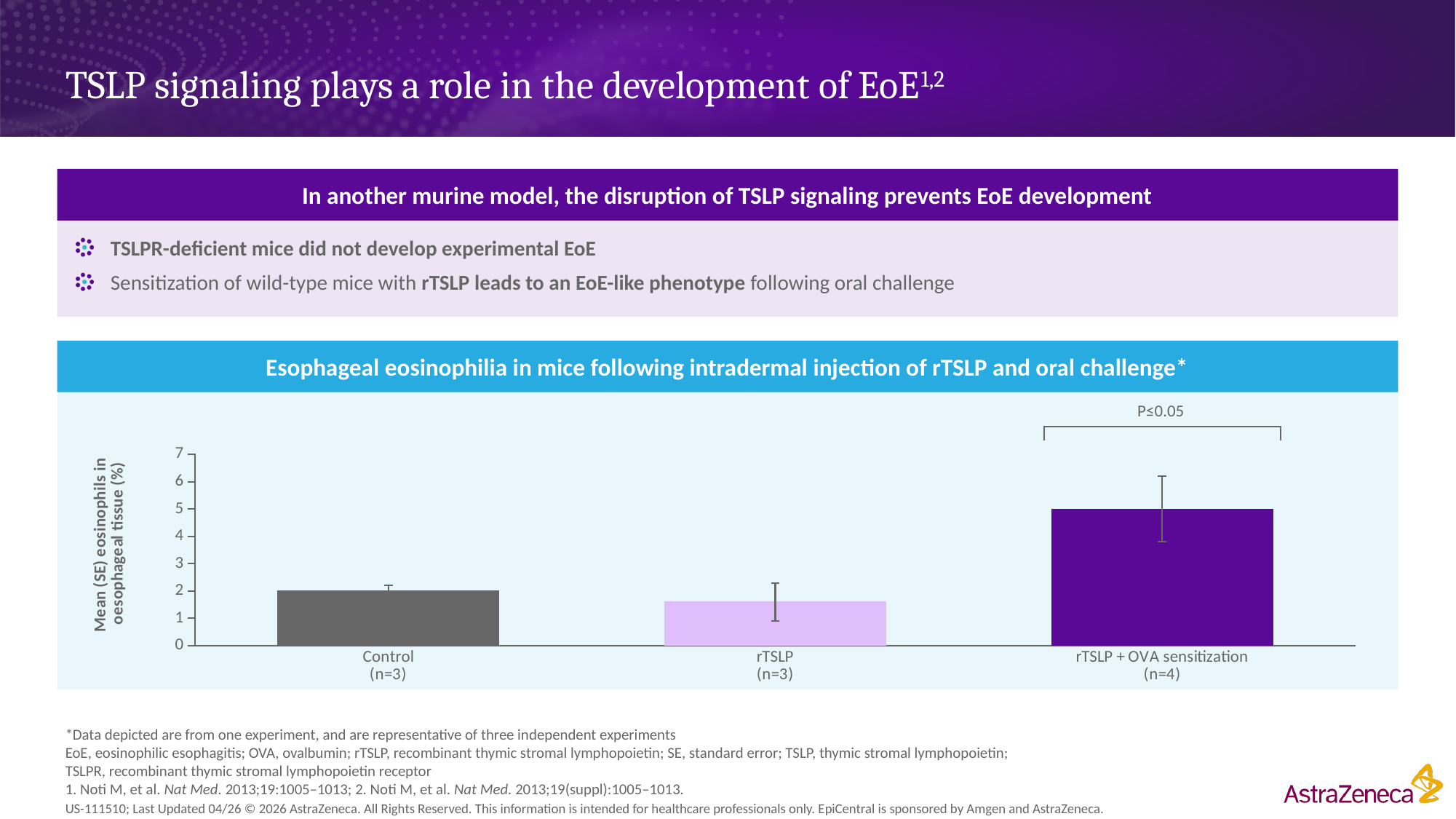
What is the mean (SE) eosinophils in oesophageal tissue (%) for the rTSLP + OVA sensitization group? 5 Which has a larger mean eosinophil percentage, Control or rTSLP? Control How many categories (bars) are plotted in the chart? 3 Is the value for rTSLP + OVA sensitization greater or less than 4? greater What kind of chart is shown on the slide? Bar chart What is the mean (SE) eosinophils in oesophageal tissue (%) for the Control group? 2 What is the difference between the values for rTSLP + OVA sensitization and Control? 3 Which category has the highest mean eosinophil percentage? rTSLP + OVA sensitization (n=4) What P-value is shown above the rTSLP + OVA sensitization bar? P≤0.05 What is the title of the chart? Esophageal eosinophilia in mice following intradermal injection of rTSLP and oral challenge* Is the value for rTSLP (n=3) greater or less than 2? less Which category has the lowest mean eosinophil percentage? rTSLP (n=3)